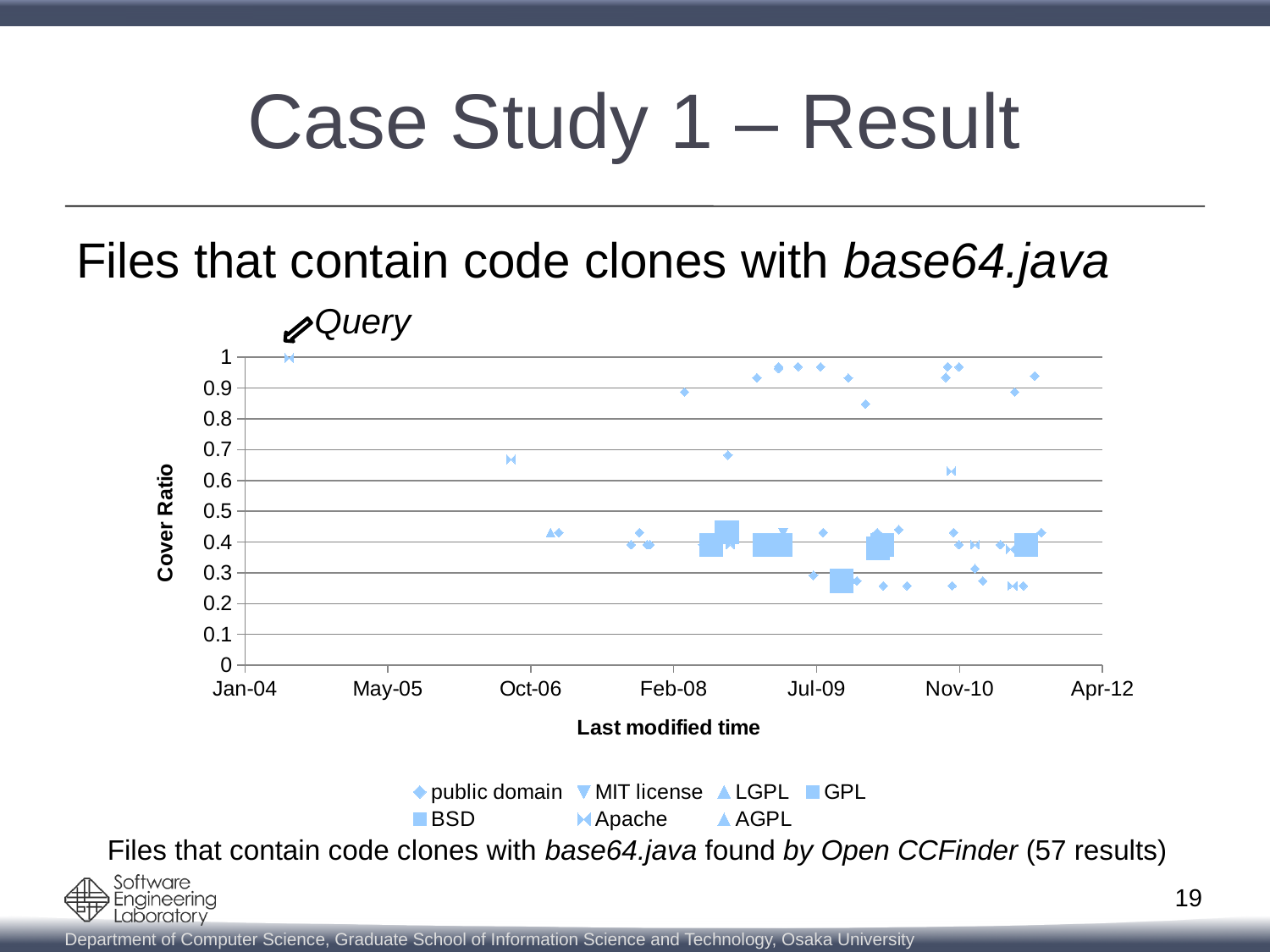
What is the title of the horizontal axis of the chart? Last modified time What is the title of the vertical axis of the chart? Cover Ratio What kind of chart is shown on the slide? scatter chart Is the Cover Ratio of the Apache point near Oct-06 greater or less than 0.5? greater What is the earliest date label shown on the horizontal axis? Jan-04 What is the highest value shown on the Cover Ratio axis? 1 Which series has the highest Cover Ratio on the chart? Apache Is the Cover Ratio of the large BSD square near Jul-09 greater or less than 0.5? less What Cover Ratio value does the point labelled Query have? 1 According to the caption below the chart, how many results were found by Open CCFinder? 57 How many series does the chart legend list? 7 Is the Cover Ratio of the Apache point near Nov-10 greater or less than 0.5? greater